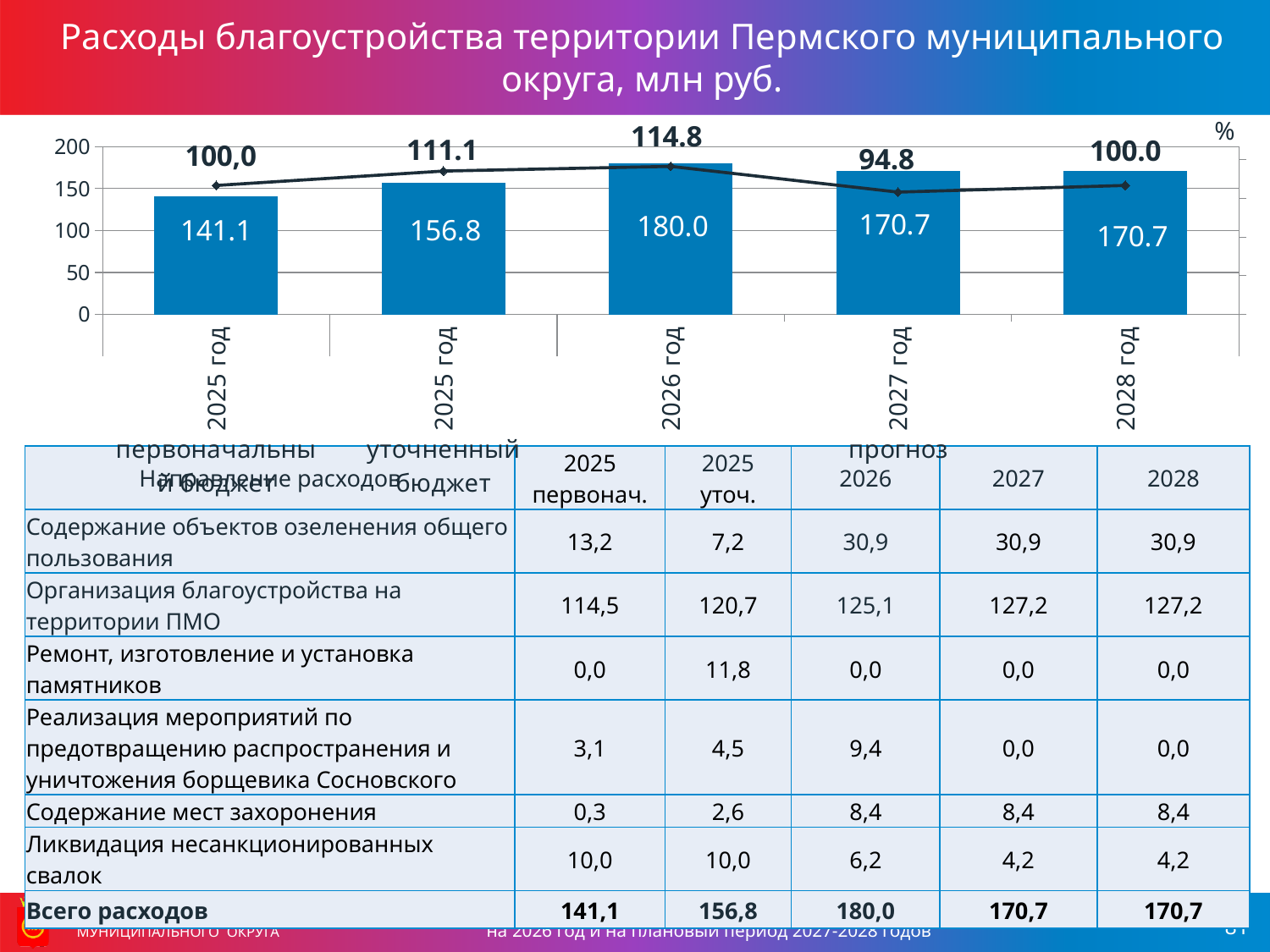
What is the value of the bar for 2026 год? 180.0 What is the value of the first 2025 год bar (первоначальный бюджет)? 141.1 What type of chart is shown on the slide? Bar chart with a line overlay Which year has the highest bar value? 2026 год What percentage value is shown on the line above the 2027 год bar? 94.8 Which bar has the lowest value? 2025 год (первоначальный бюджет), 141.1 What is the value of the second 2025 год bar (уточненный бюджет)? 156.8 What is the value of the bar for 2027 год? 170.7 Which is larger, the bar for 2026 год or the bar for 2028 год? 2026 год What is the difference between the bar values for 2026 год and 2027 год? 9.3 How many bars are plotted in the chart? 5 What percentage value is shown on the line above the 2026 год bar? 114.8